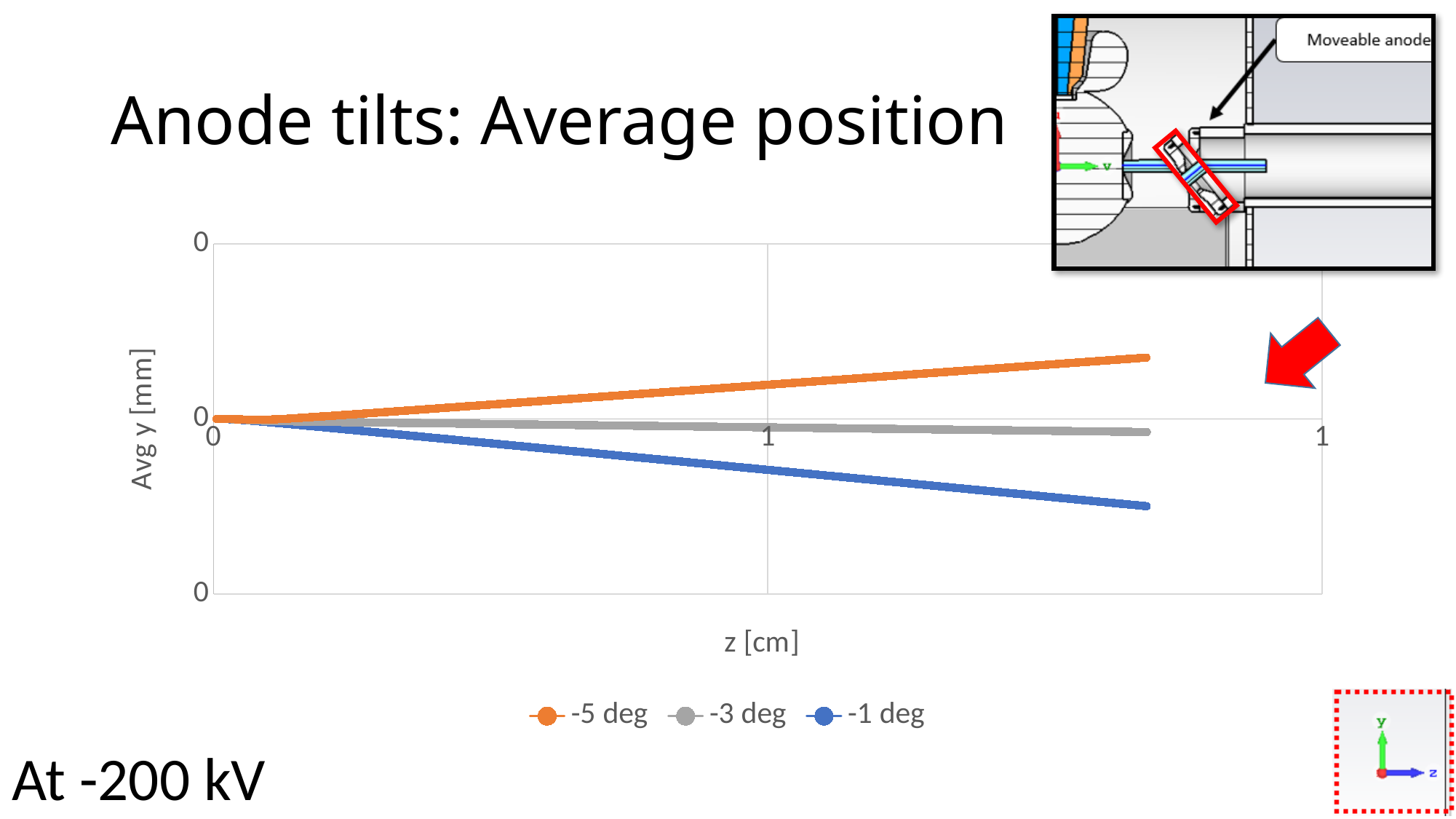
Does the -1 deg series rise or fall as z increases? fall At the right end of the lines, is the Avg y value for -5 deg greater or less than 0? greater Which series has the highest Avg y value at the right end of the lines? -5 deg How many series does the chart legend list? 3 What kind of chart is shown on the slide? line chart What is the label of the vertical axis? Avg y [mm] Which series has the lowest Avg y value at the right end of the lines? -1 deg At the right end of the lines, which series has the larger Avg y value, -5 deg or -1 deg? -5 deg At the right end of the lines, which series has the larger Avg y value, -3 deg or -1 deg? -3 deg What is the title of the chart on the slide? Anode tilts: Average position Does the -5 deg series rise or fall as z increases? rise At the right end of the lines, is the Avg y value for -1 deg greater or less than 0? less